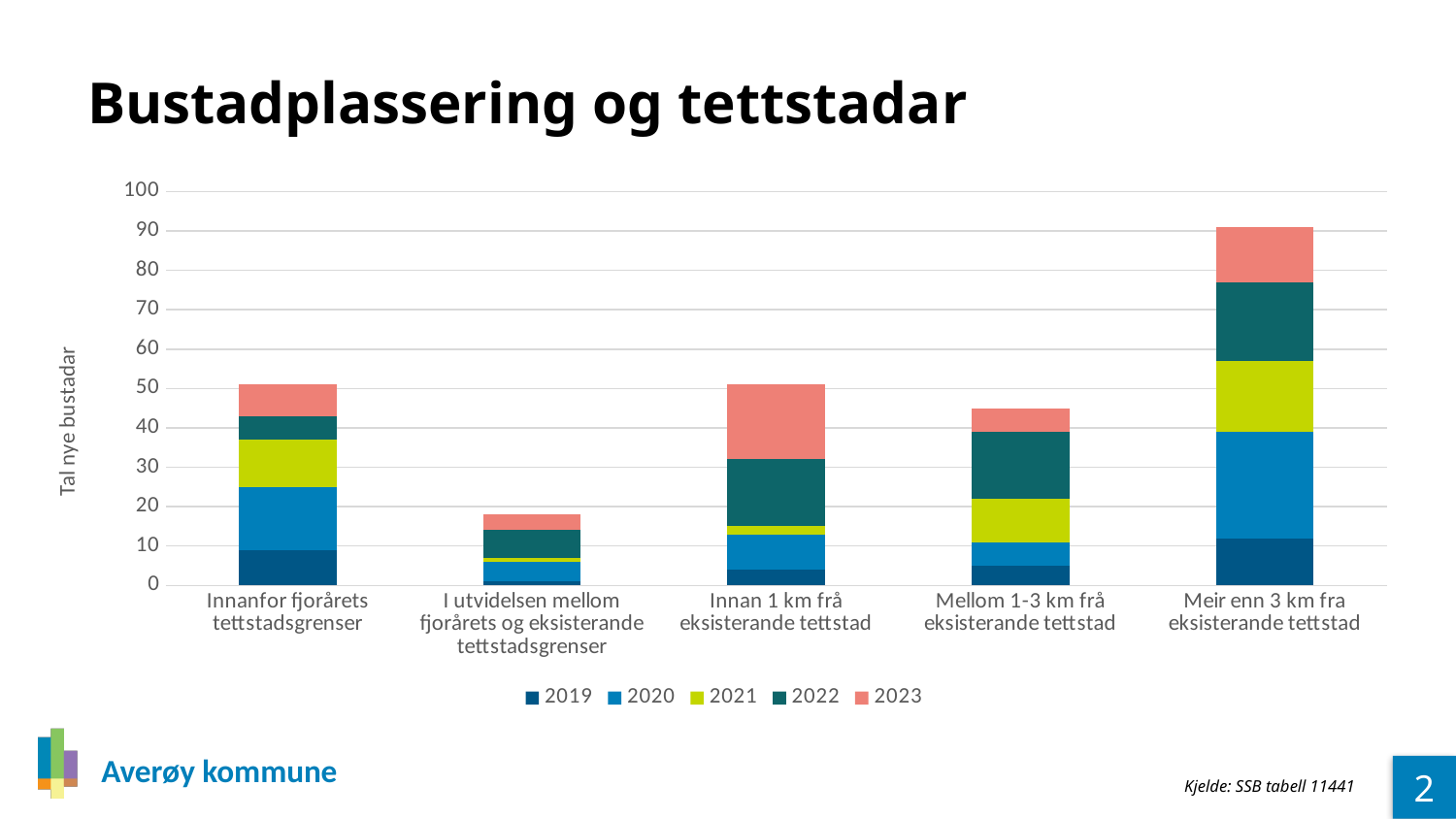
What is the label on the vertical axis of the chart? Tal nye bustadar Is the total stacked value for 'Meir enn 3 km fra eksisterande tettstad' greater or less than 80? greater Which has a larger total stacked bar: 'Innanfor fjorårets tettstadsgrenser' or 'I utvidelsen mellom fjorårets og eksisterande tettstadsgrenser'? Innanfor fjorårets tettstadsgrenser Is the total stacked value for 'I utvidelsen mellom fjorårets og eksisterande tettstadsgrenser' greater or less than 20? less Which has a larger total stacked bar: 'Meir enn 3 km fra eksisterande tettstad' or 'Mellom 1-3 km frå eksisterande tettstad'? Meir enn 3 km fra eksisterande tettstad How many series does the legend list? 5 What kind of chart is shown on the slide? Stacked bar chart How many categories are shown along the x axis? 5 What is the title of the chart on the slide? Bustadplassering og tettstadar Which category has the shortest stacked bar overall? I utvidelsen mellom fjorårets og eksisterande tettstadsgrenser Which category has the tallest stacked bar overall? Meir enn 3 km fra eksisterande tettstad Is the total stacked value for 'Innan 1 km frå eksisterande tettstad' greater or less than 40? greater